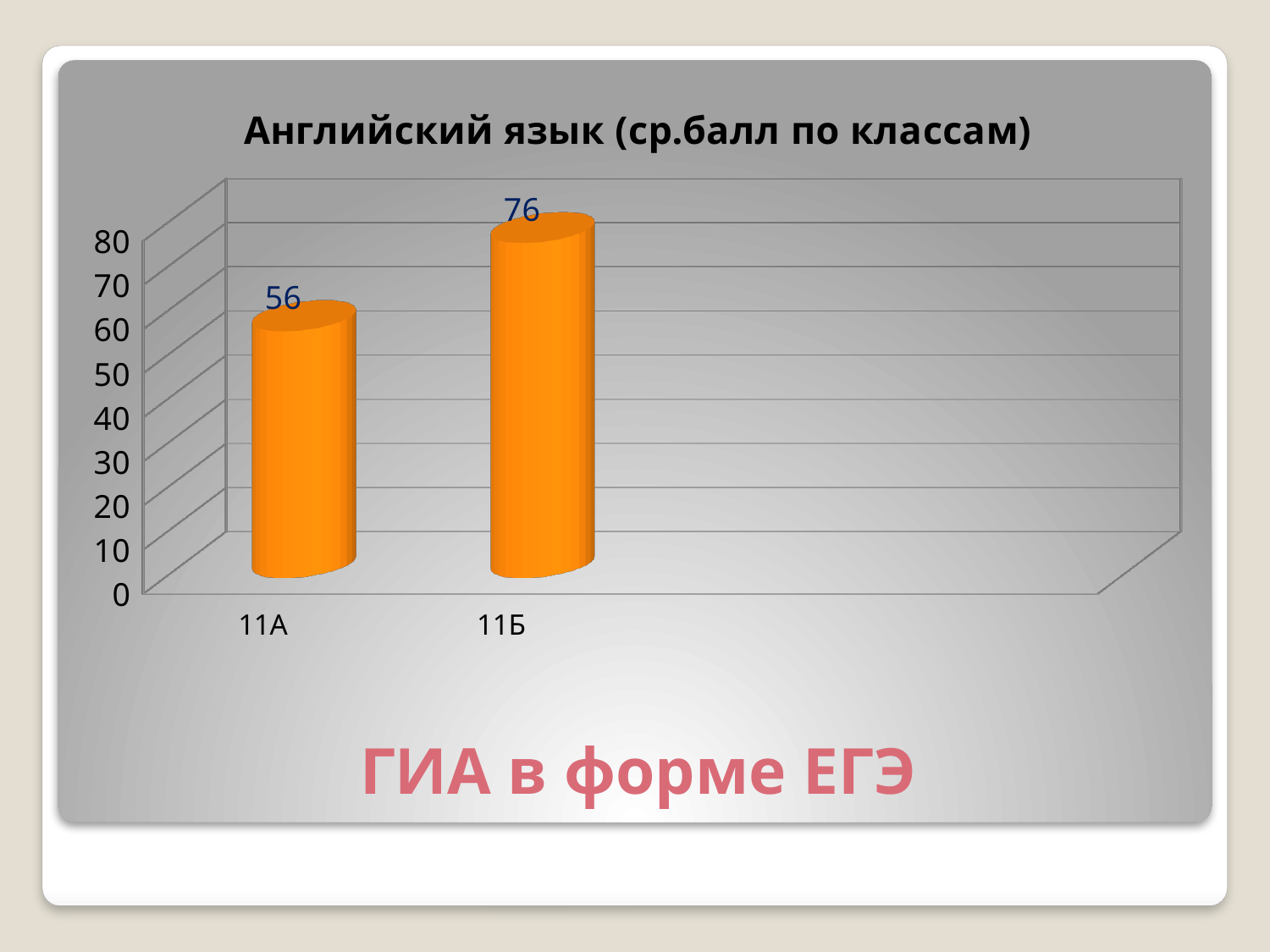
Which class has the larger average score, 11А or 11Б? 11Б Is the value for 11Б greater or less than 70? greater What is the title of the chart? Английский язык (ср.балл по классам) Which class has the lowest average score? 11А What is the difference between the average scores of 11Б and 11А? 20 What kind of chart is shown on the slide? bar chart What is the average score for class 11А? 56 How many classes are shown on the chart? 2 Which class has the highest average score? 11Б What is the average score for class 11Б? 76 What colour are the bars on the chart? orange Is the value for 11А greater or less than 60? less